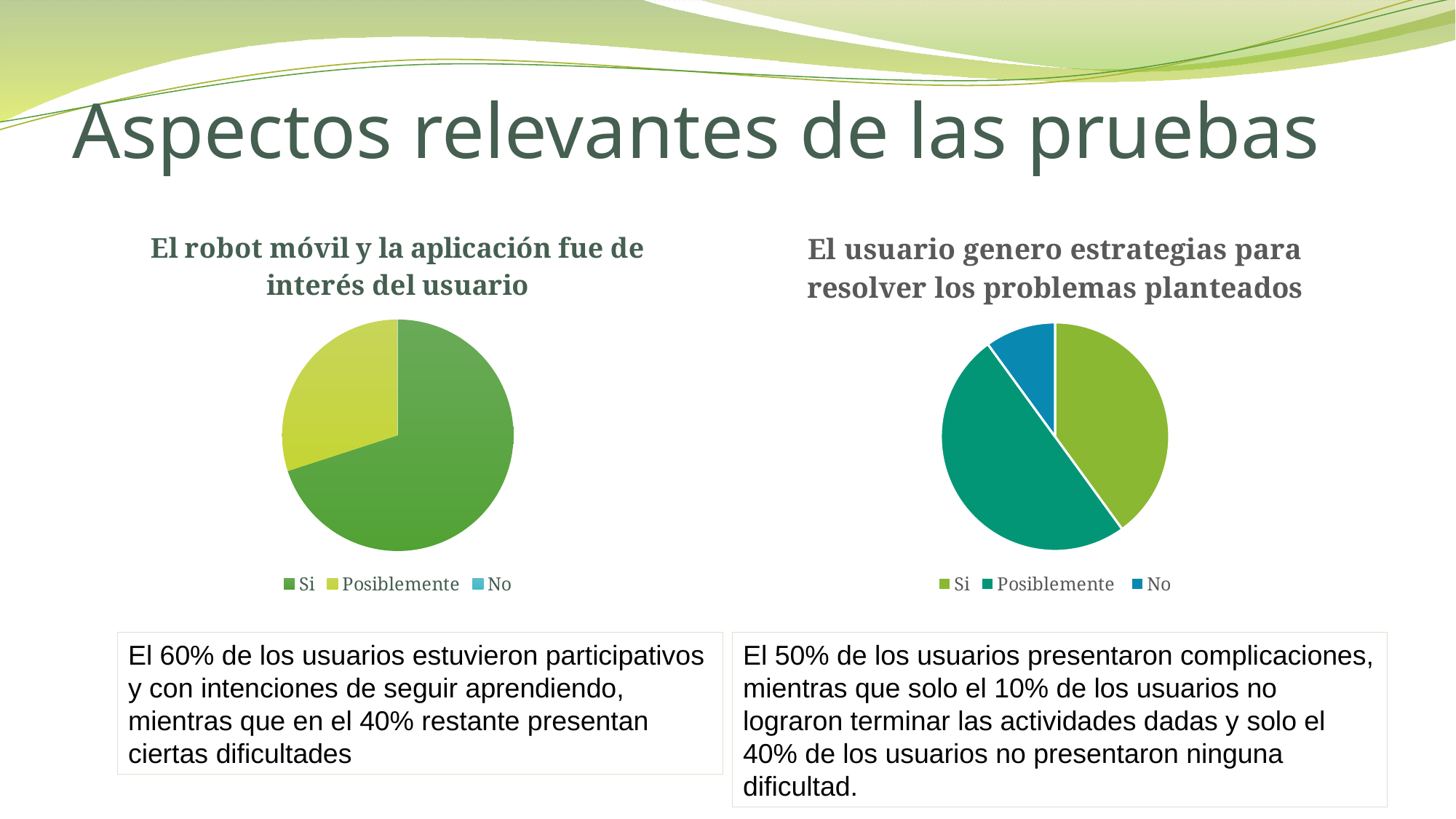
How many entries does the legend of the left chart ('El robot móvil y la aplicación fue de interés del usuario') list? 3 In the right chart ('El usuario genero estrategias para resolver los problemas planteados'), which slice is larger, 'Si' or 'No'? Si In the right chart ('El usuario genero estrategias para resolver los problemas planteados'), which slice is larger, 'Posiblemente' or 'Si'? Posiblemente What kind of chart is the chart titled 'El usuario genero estrategias para resolver los problemas planteados'? Pie chart What are the legend entries of the left chart ('El robot móvil y la aplicación fue de interés del usuario')? Si, Posiblemente, No In the left chart ('El robot móvil y la aplicación fue de interés del usuario'), which category has the largest slice? Si How many visible slices does the right chart ('El usuario genero estrategias para resolver los problemas planteados') have? 3 What kind of chart is the chart titled 'El robot móvil y la aplicación fue de interés del usuario'? Pie chart In the right chart ('El usuario genero estrategias para resolver los problemas planteados'), which category has the largest slice? Posiblemente In the right chart ('El usuario genero estrategias para resolver los problemas planteados'), which category has the smallest slice? No How many entries does the legend of the right chart ('El usuario genero estrategias para resolver los problemas planteados') list? 3 In the left chart ('El robot móvil y la aplicación fue de interés del usuario'), which slice is larger, 'Si' or 'Posiblemente'? Si